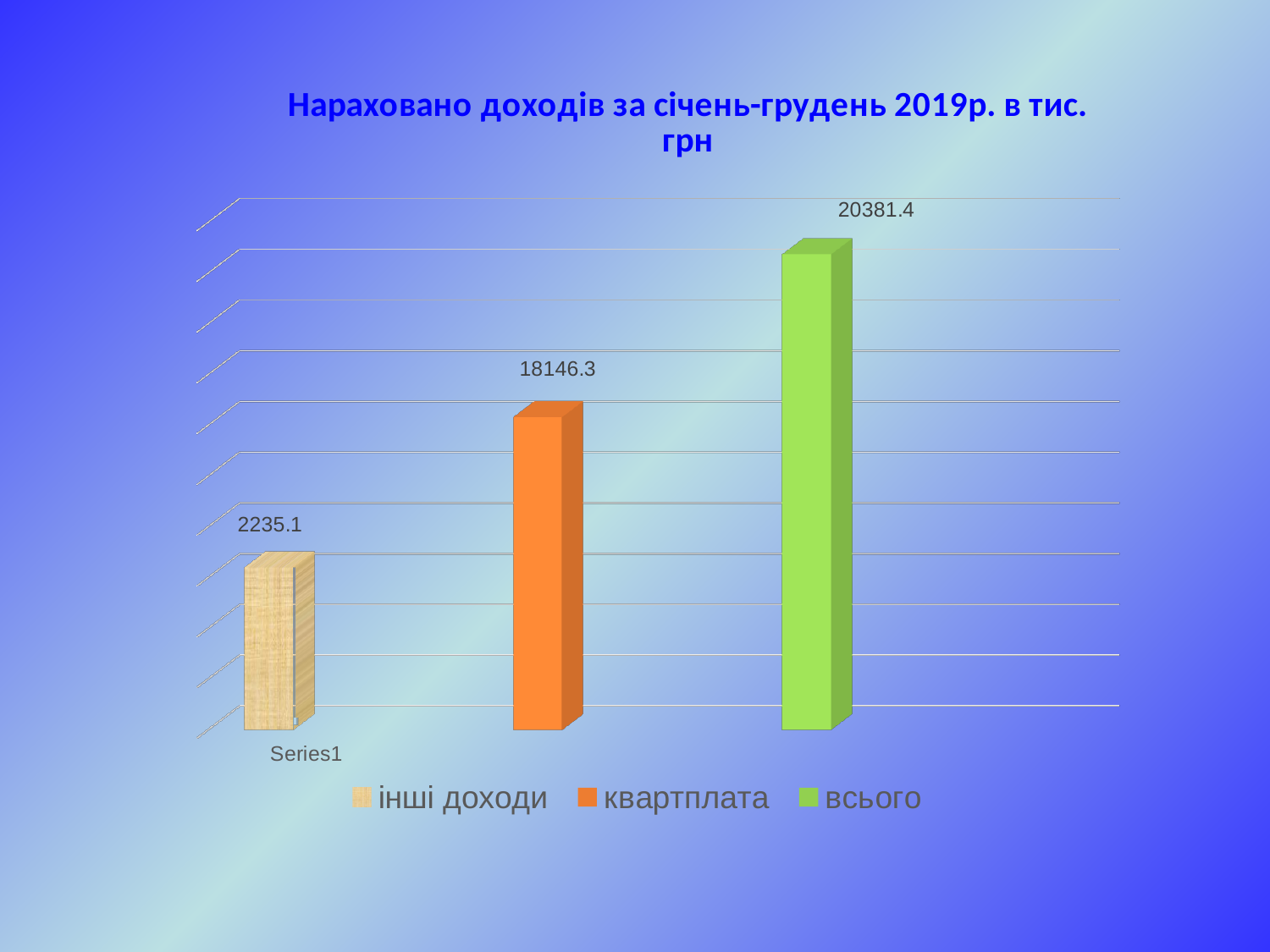
What is the value for всього? 20381.4 How many series does the legend list? 3 What is the difference between квартплата and інші доходи? 15911.2 What is the title of the chart? Нараховано доходів за січень-грудень 2019р. в тис. грн What is the value for інші доходи? 2235.1 Which series has the highest value? всього Which series has the lowest value? інші доходи What colour is the bar for всього? green What kind of chart is shown on the slide? bar chart What is the difference between всього and квартплата? 2235.1 Which is larger, квартплата or інші доходи? квартплата What is the value for квартплата? 18146.3